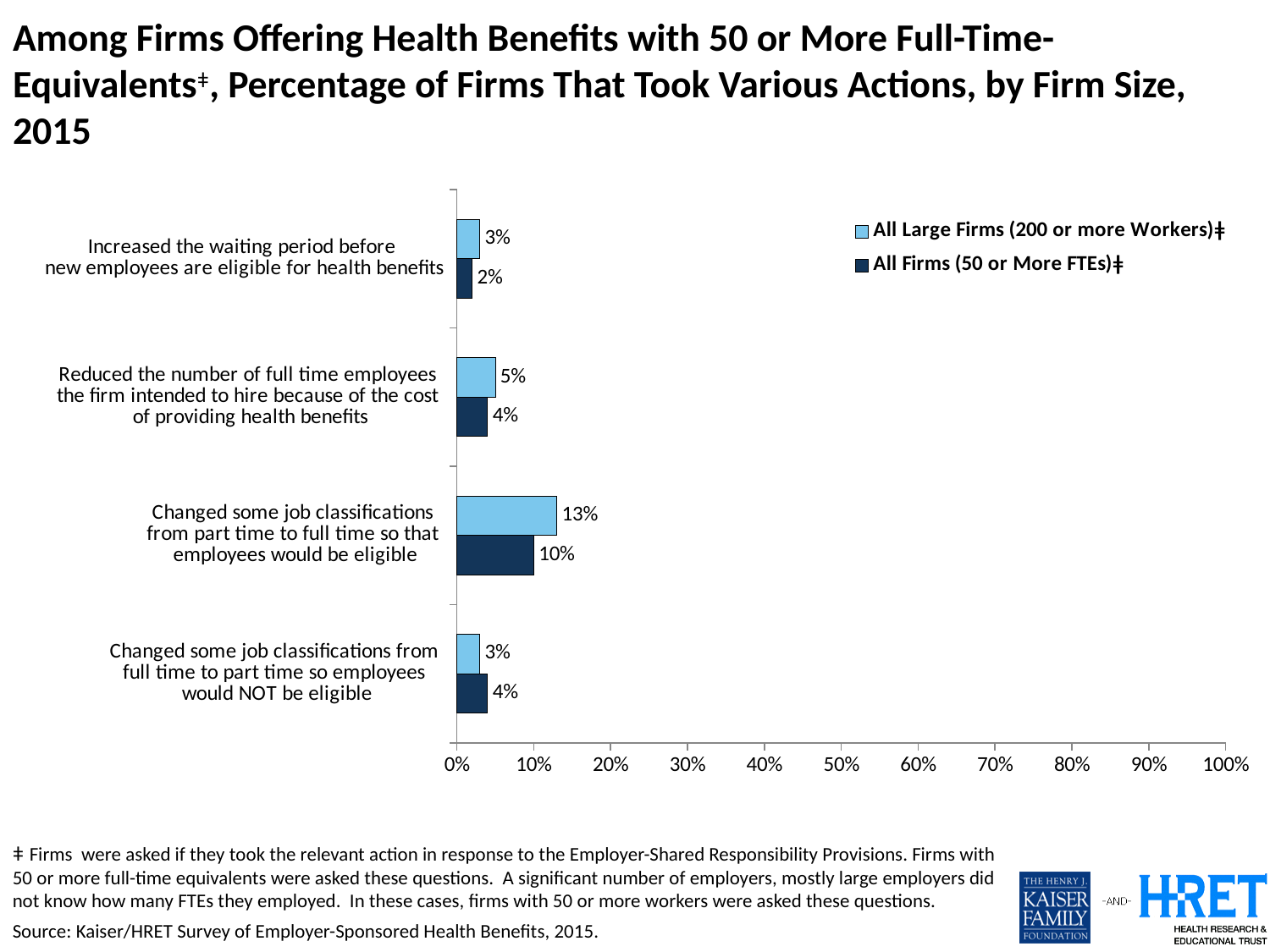
For changing job classifications from full time to part time so employees would NOT be eligible, which series has the larger value: All Large Firms or All Firms (50 or More FTEs)? All Firms (50 or More FTEs) What kind of chart is shown on the slide? Bar chart Which action has the highest percentage for All Large Firms (200 or more Workers)? Changed some job classifications from part time to full time so that employees would be eligible What percentage of All Large Firms (200 or more Workers) changed some job classifications from part time to full time so that employees would be eligible? 13% What percentage of All Firms (50 or More FTEs) reduced the number of full time employees the firm intended to hire because of the cost of providing health benefits? 4% What percentage of All Firms (50 or More FTEs) increased the waiting period before new employees are eligible for health benefits? 2% How many series does the legend list? 2 What percentage of All Large Firms (200 or more Workers) changed some job classifications from full time to part time so employees would NOT be eligible? 3% Which action has the lowest percentage for All Firms (50 or More FTEs)? Increased the waiting period before new employees are eligible for health benefits Is the value for All Large Firms that changed job classifications from part time to full time greater or less than 20%? less What is the difference between All Large Firms and All Firms (50 or More FTEs) for changing job classifications from part time to full time? 3% How many actions (categories) are shown on the chart? 4